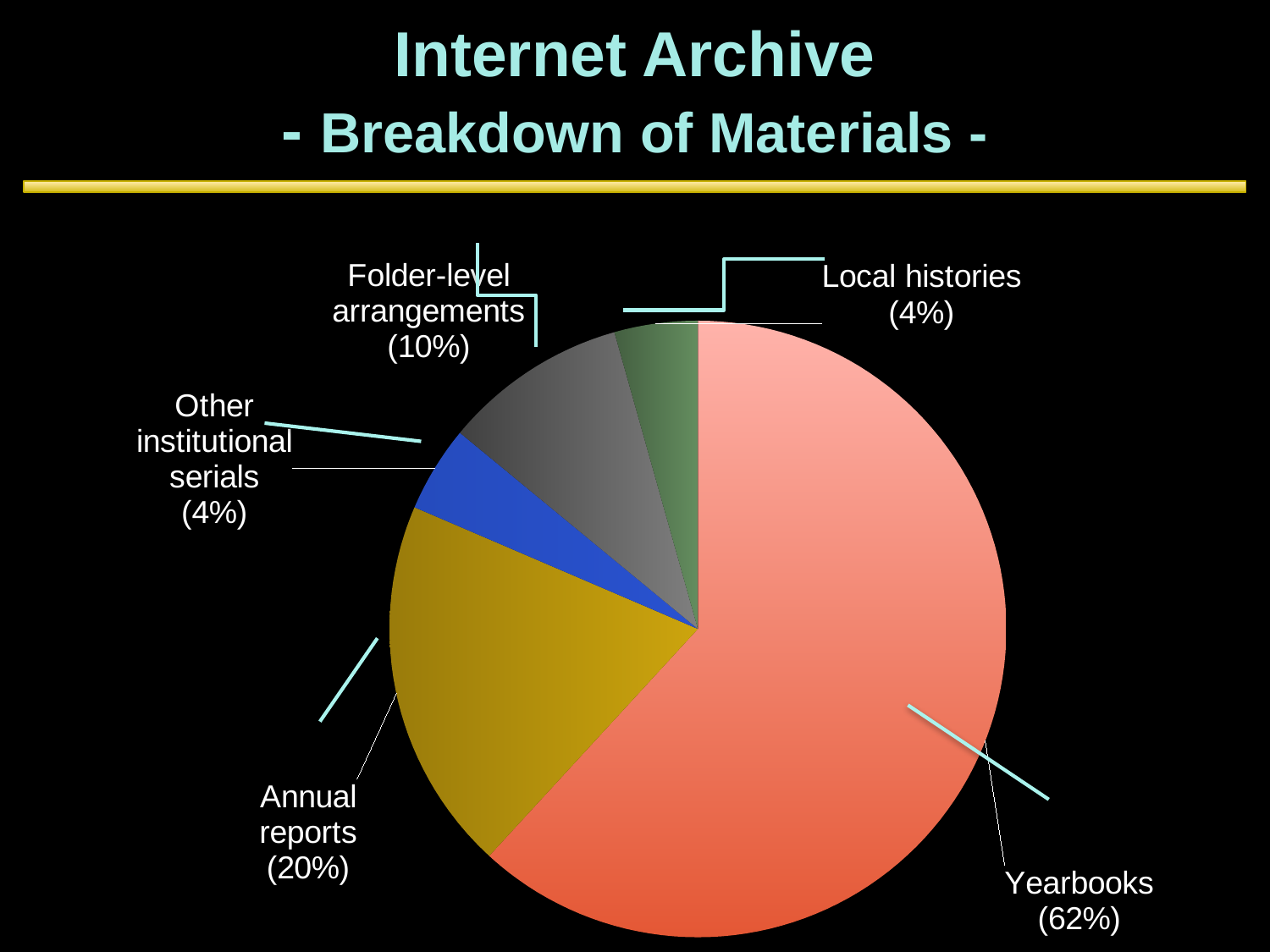
What is the difference in percentage points between Folder-level arrangements and Local histories? 6 What is the difference in percentage points between Yearbooks and Annual reports? 42 What is the title of the chart on the slide? Internet Archive - Breakdown of Materials - What share of materials do Yearbooks make up? 62% What share of materials do Other institutional serials make up? 4% What type of chart is shown on the slide? pie chart What share of materials do Local histories make up? 4% Which is larger, the share for Annual reports or the share for Folder-level arrangements? Annual reports How many categories are shown in the pie chart? 5 Which category has the largest share of the pie? Yearbooks